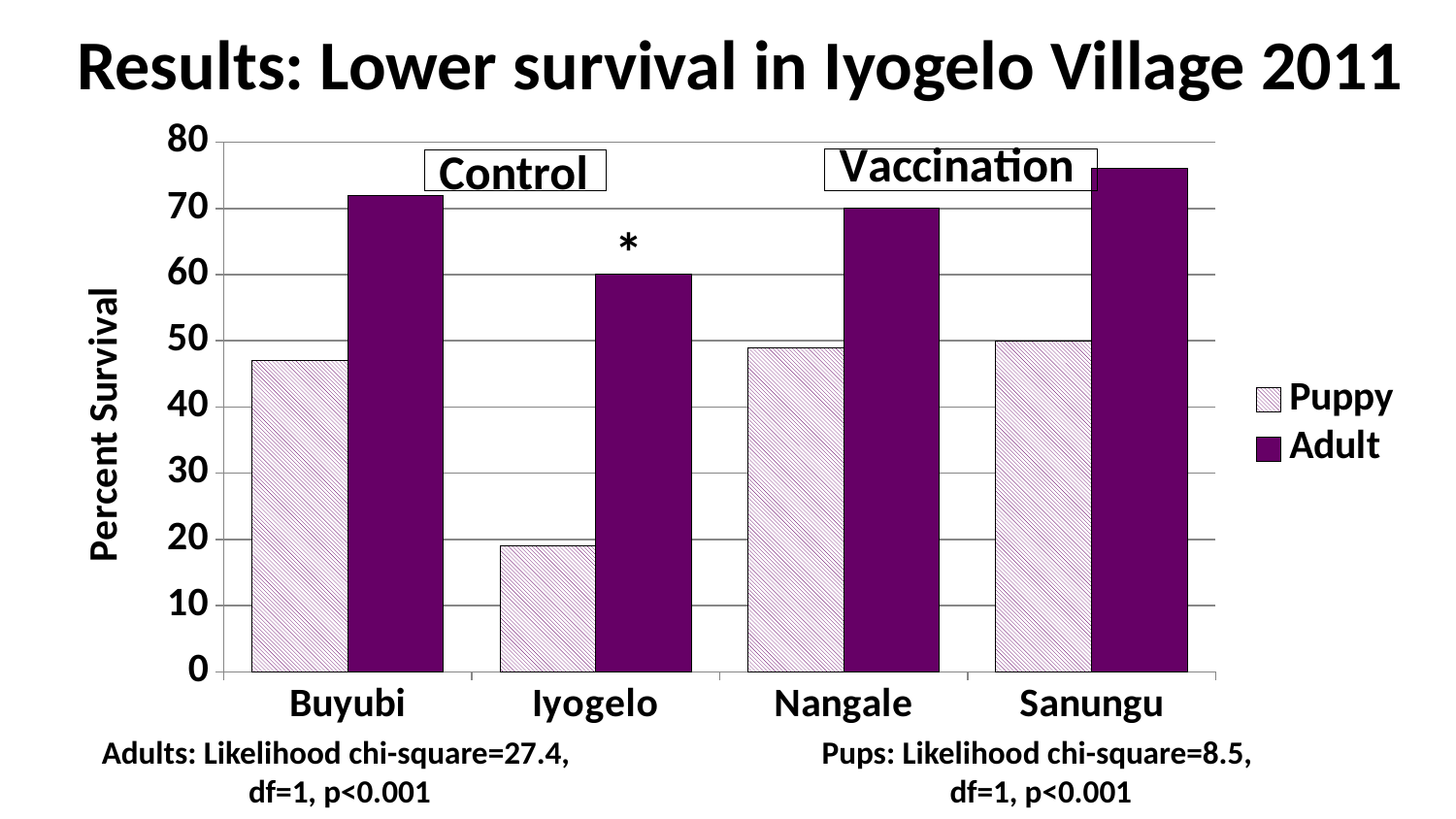
Which is larger, the Adult survival for Buyubi or the Adult survival for Iyogelo? Buyubi Which two groups are labelled above the bars in the chart? Control and Vaccination Is the Puppy survival for Iyogelo greater or less than 20? less Which village has the lowest Adult survival? Iyogelo Which village has the highest Adult survival? Sanungu Is the Adult survival for Buyubi greater or less than 70? greater Is the Puppy survival for Buyubi greater or less than 50? less What kind of chart is shown on the slide? bar chart Which village has the lowest Puppy survival? Iyogelo How many series does the chart's legend list? 2 How many villages are shown on the x axis of the chart? 4 What is the label on the chart's vertical axis? Percent Survival